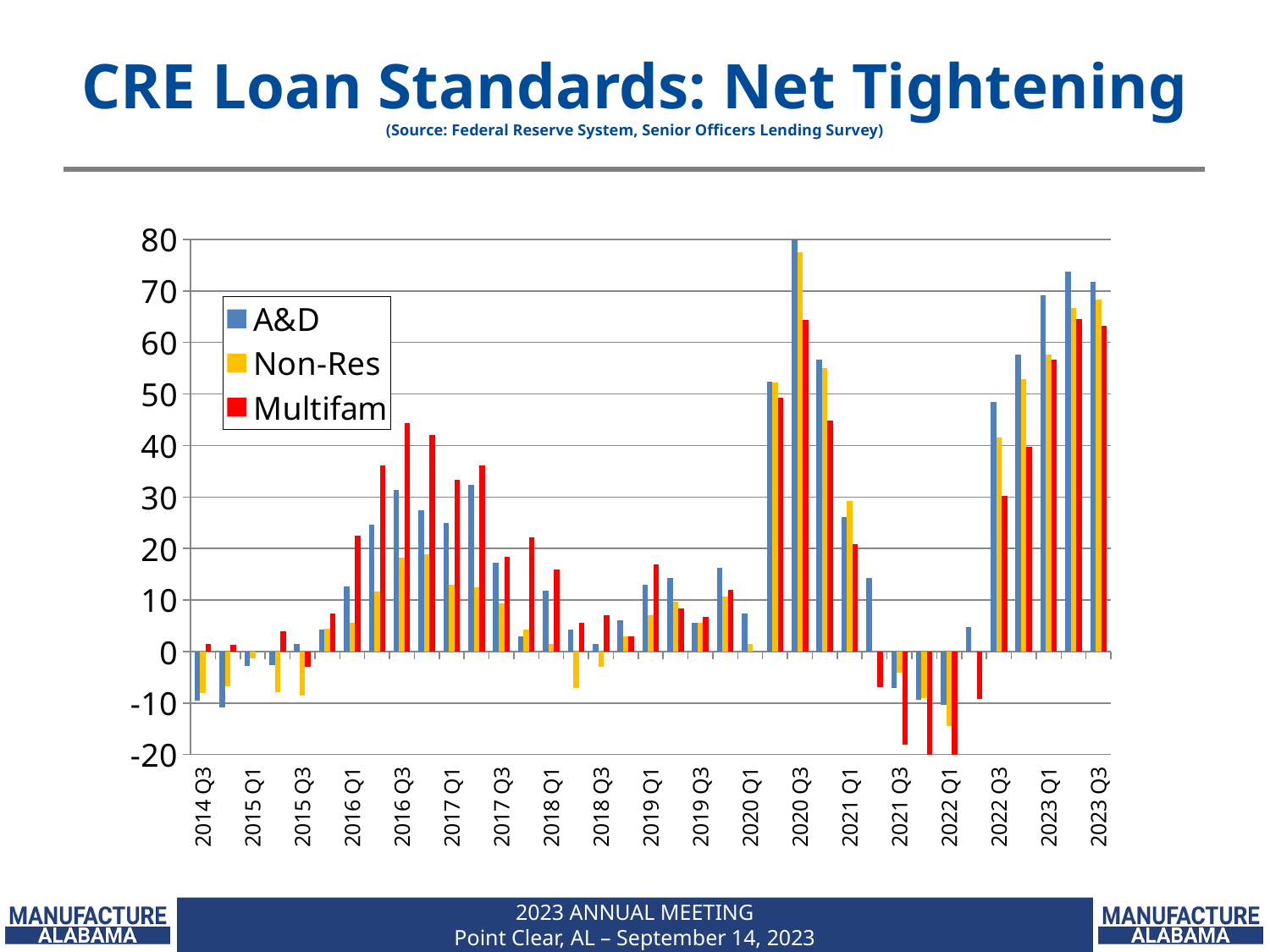
Do the A&D values rise or fall from 2020 Q3 to 2021 Q3? Fall What kind of chart is shown on the slide? Bar chart In which quarter does the Non-Res series reach its highest value? 2020 Q3 What is the title of the chart on the slide? CRE Loan Standards: Net Tightening How many series does the chart legend list? 3 Which series is shown in red in the chart legend? Multifam Is the Multifam value for 2022 Q1 greater or less than -10? less Is the A&D value for 2020 Q3 greater or less than 70? greater In 2016 Q3, which is larger: the A&D value or the Multifam value? Multifam Is the Multifam value for 2016 Q3 greater or less than 40? greater In 2023 Q1, which is larger: the A&D value or the Non-Res value? A&D In which quarter does the A&D series reach its highest value? 2020 Q3